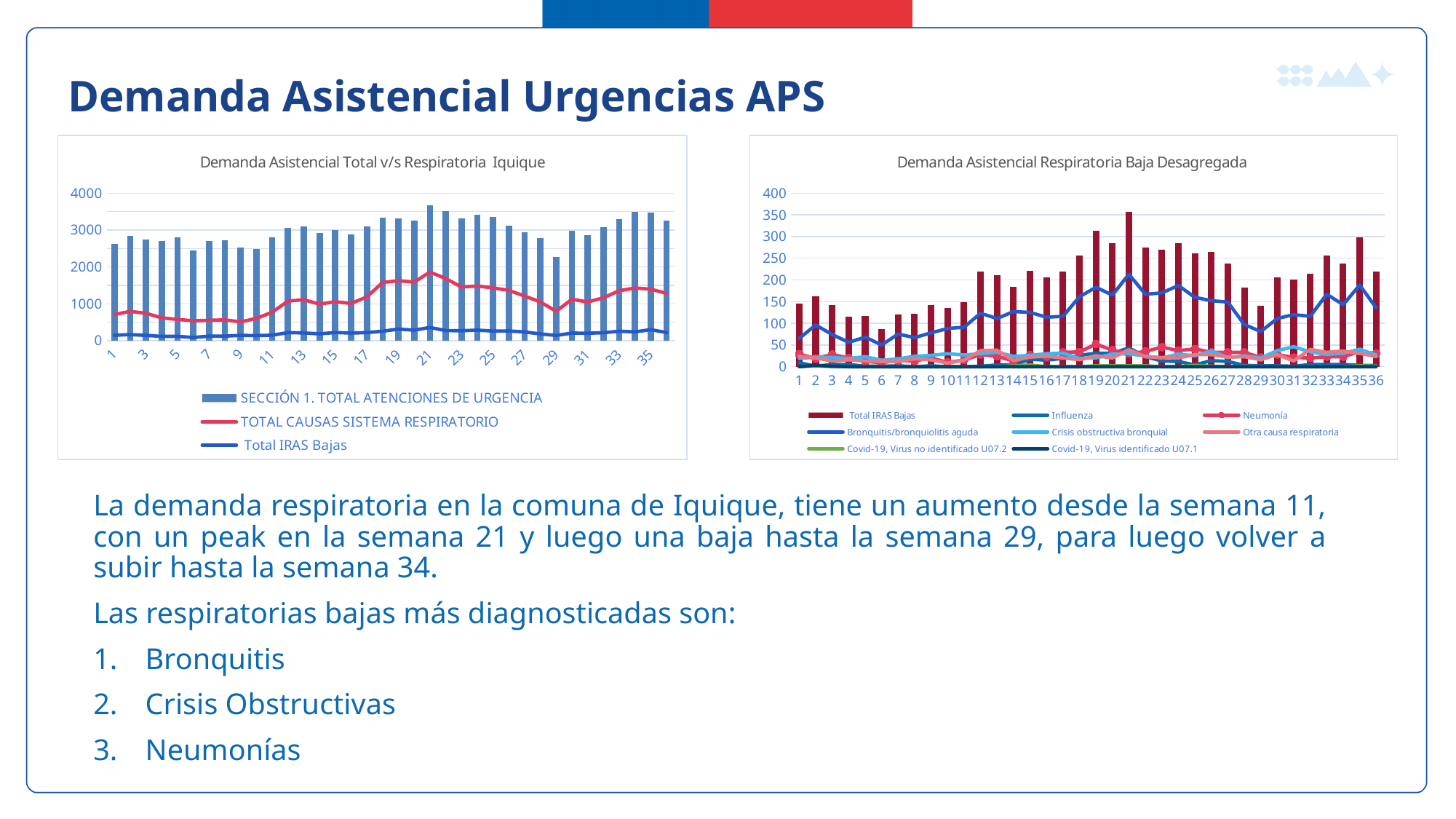
In the chart titled 'Demanda Asistencial Respiratoria Baja Desagregada', at which week is the Total IRAS Bajas bar lowest? 6 In the chart titled 'Demanda Asistencial Total v/s Respiratoria Iquique', is the TOTAL CAUSAS SISTEMA RESPIRATORIO value at week 1 greater or less than 1000? less In the chart titled 'Demanda Asistencial Total v/s Respiratoria Iquique', at which week is the bar for SECCIÓN 1. TOTAL ATENCIONES DE URGENCIA highest? 21 In the chart titled 'Demanda Asistencial Respiratoria Baja Desagregada', is the Total IRAS Bajas value at week 21 greater or less than 300? greater How many series does the legend of the chart titled 'Demanda Asistencial Total v/s Respiratoria Iquique' list? 3 In the chart titled 'Demanda Asistencial Total v/s Respiratoria Iquique', is the bar value at week 21 greater or less than 3000? greater How many series does the legend of the chart titled 'Demanda Asistencial Respiratoria Baja Desagregada' list? 8 In the chart titled 'Demanda Asistencial Respiratoria Baja Desagregada', at which week is the Total IRAS Bajas bar highest? 21 How many weeks are shown on the x axis of the chart titled 'Demanda Asistencial Respiratoria Baja Desagregada'? 36 In the chart titled 'Demanda Asistencial Total v/s Respiratoria Iquique', at which week is the bar for SECCIÓN 1. TOTAL ATENCIONES DE URGENCIA lowest? 29